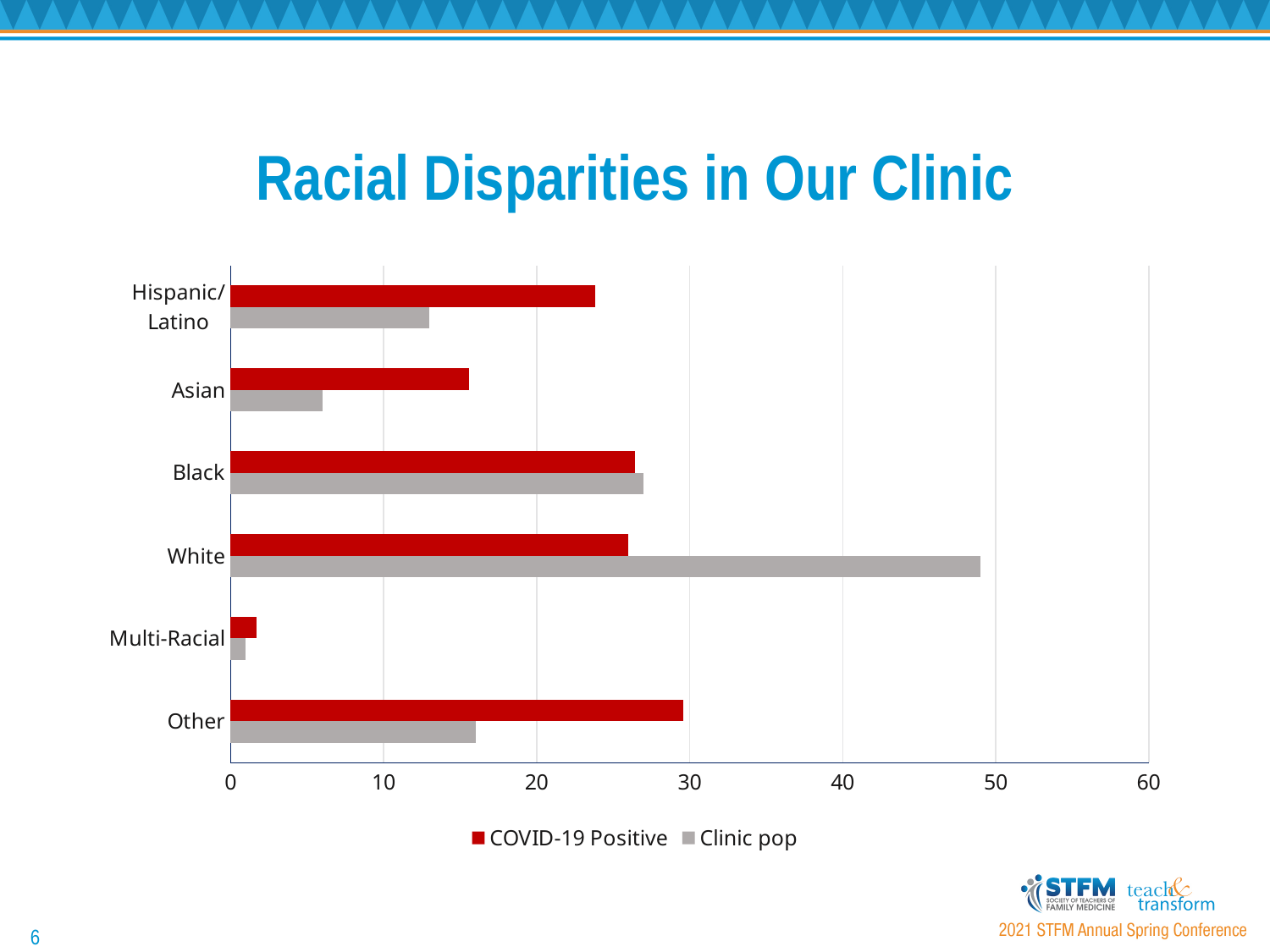
Which category has the highest COVID-19 Positive value? Other Is the Clinic pop value for Asian greater or less than 10? less Which category has the lowest Clinic pop value? Multi-Racial What kind of chart is shown on the slide? bar chart Which category has the lowest COVID-19 Positive value? Multi-Racial Which category has the highest Clinic pop value? White How many racial categories are shown on the chart? 6 Is the Clinic pop value for White greater or less than 40? greater For Hispanic/Latino, which is larger: COVID-19 Positive or Clinic pop? COVID-19 Positive For White, which is larger: COVID-19 Positive or Clinic pop? Clinic pop How many series does the legend list? 2 What is the title of the chart? Racial Disparities in Our Clinic